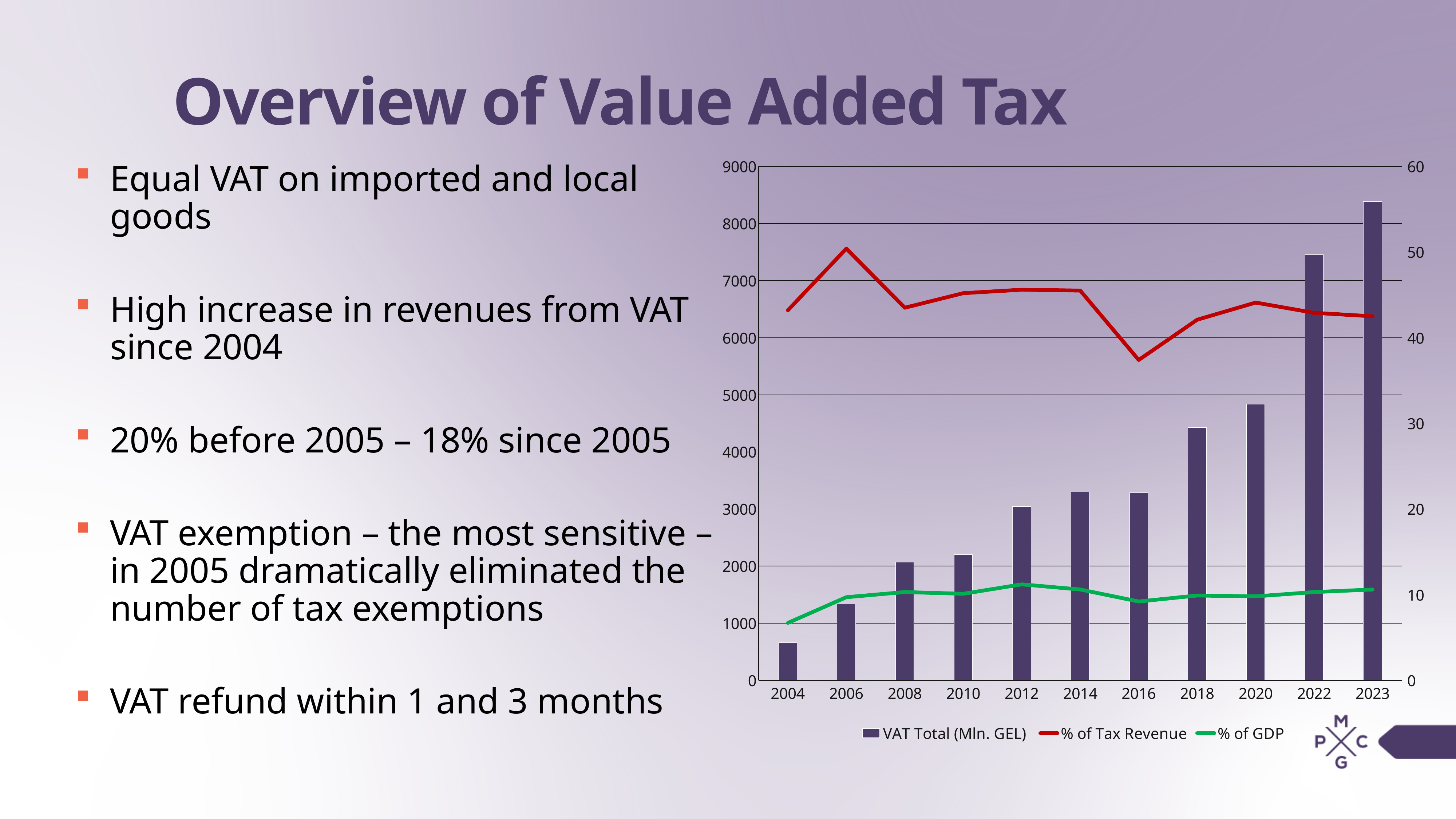
Is the VAT Total (Mln. GEL) value for 2004 greater or less than 1000? less Is the % of Tax Revenue value for 2016 greater or less than 40? less How many series does the chart legend list? 3 In which year does the % of Tax Revenue line reach its lowest point? 2016 In which year does the % of Tax Revenue line reach its highest point? 2006 What kind of chart is shown on the slide? A combination bar and line chart Which year has the highest VAT Total (Mln. GEL) bar? 2023 How many years are shown on the x axis of the chart? 11 Is the VAT Total (Mln. GEL) value for 2023 greater or less than 8000? greater Which year has a larger VAT Total (Mln. GEL) bar, 2020 or 2022? 2022 Which year has the lowest VAT Total (Mln. GEL) bar? 2004 Do the VAT Total (Mln. GEL) bars generally rise or fall from 2004 to 2023? rise